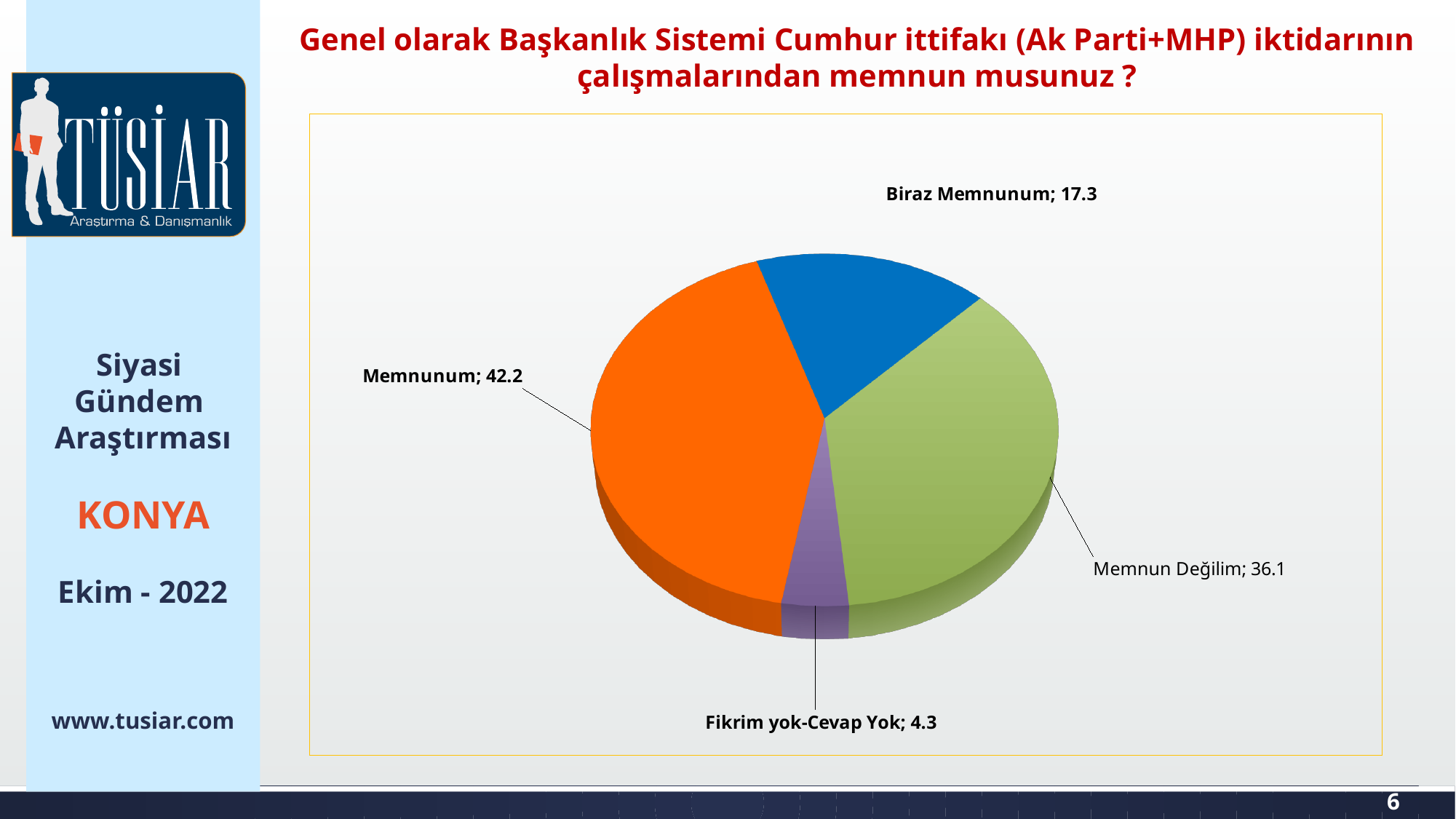
What kind of chart is shown on the slide? Pie chart What is the value for Memnunum? 42.2 What is the value for Biraz Memnunum? 17.3 Which category has the largest slice? Memnunum Which is larger, the value for Memnun Değilim or the value for Biraz Memnunum? Memnun Değilim What is the difference between the values for Biraz Memnunum and Fikrim yok-Cevap Yok? 13 What is the value for Fikrim yok-Cevap Yok? 4.3 What is the difference between the values for Memnunum and Memnun Değilim? 6.1 Which category has the smallest slice? Fikrim yok-Cevap Yok How many slices does the pie chart have? 4 What colour is the Memnunum slice? Orange What is the value for Memnun Değilim? 36.1